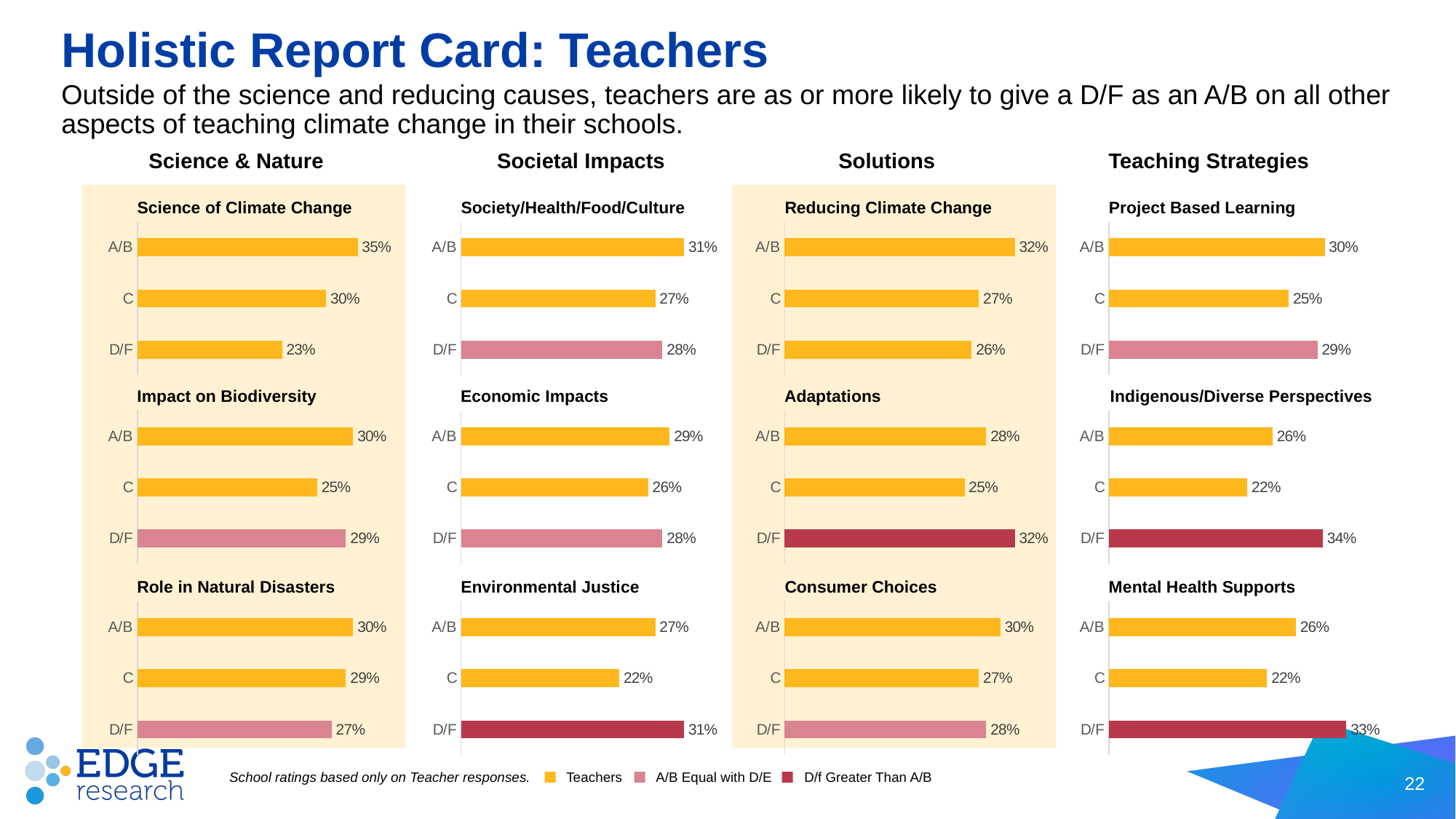
In the 'Consumer Choices' chart, what is the difference between the A/B and C values? 3% How many rating categories are shown in the 'Project Based Learning' chart? 3 In the 'Mental Health Supports' chart, which is larger, the A/B value or the D/F value? D/F In the 'Reducing Climate Change' chart, what is the value for C? 27% How many entries does the legend at the bottom of the slide list? 3 What type of chart is used for 'Economic Impacts'? Bar chart In the 'Indigenous/Diverse Perspectives' chart, what is the value for D/F? 34% In the 'Adaptations' chart, which rating has the highest value? D/F In the 'Environmental Justice' chart, which rating has the lowest value? C In the 'Science of Climate Change' chart, what percentage of teachers gave an A/B? 35% In the 'Science of Climate Change' chart, what is the difference between the A/B and D/F values? 12% In the 'Role in Natural Disasters' chart, what colour is the D/F bar? Pink